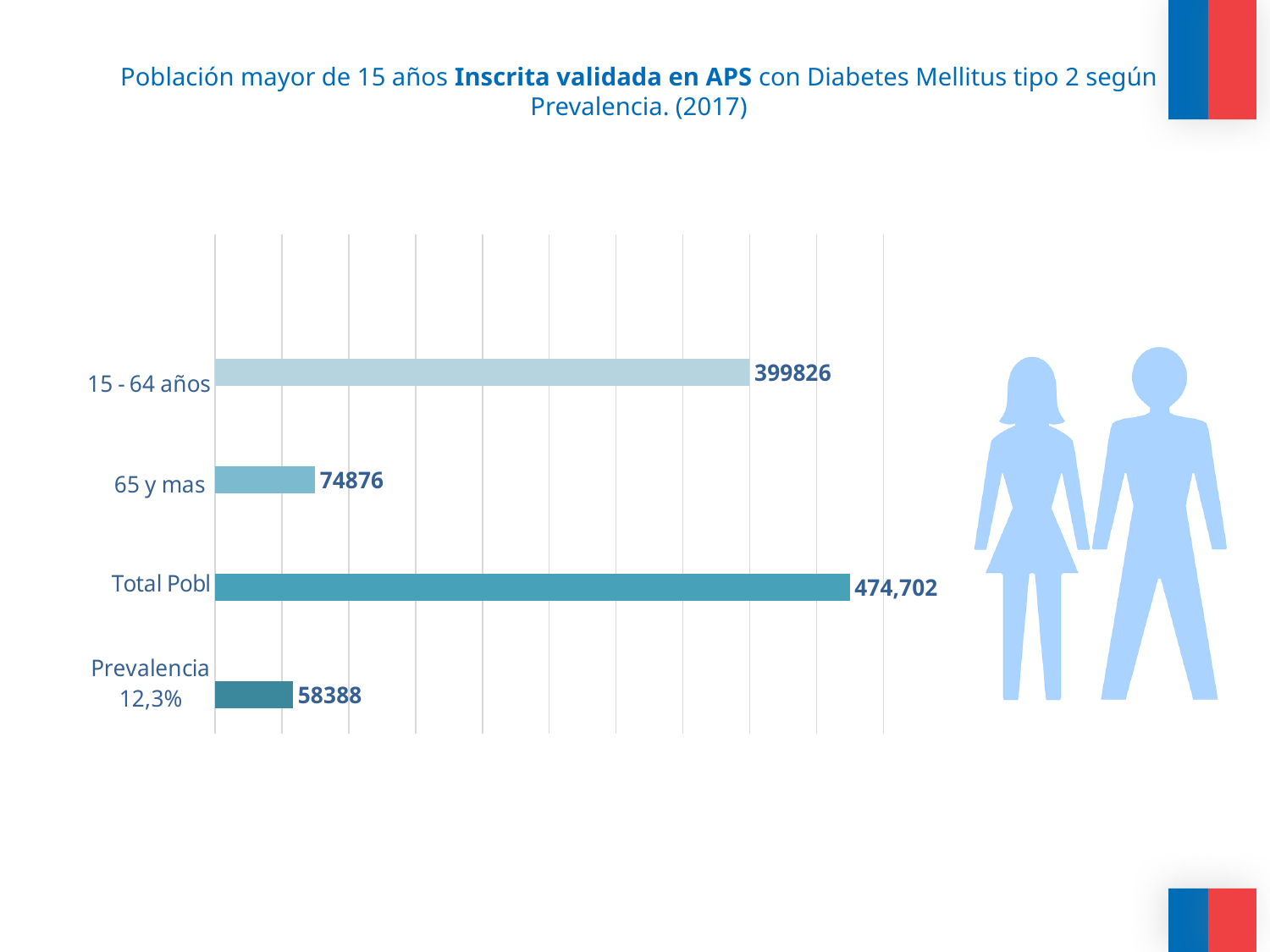
Which is larger, the value for "65 y mas" or the value for "Prevalencia 12,3%"? 65 y mas Which category has the lowest value? Prevalencia 12,3% How many categories are plotted in the chart? 4 What is the value for the "Total Pobl" category? 474,702 What is the difference between the values for "15 - 64 años" and "65 y mas"? 324950 What is the difference between the values for "65 y mas" and "Prevalencia 12,3%"? 16488 What year is given in the chart title? 2017 Which category has the highest value? Total Pobl What type of chart is shown on the slide? bar chart What is the value for the "15 - 64 años" category? 399826 What is the value for the "65 y mas" category? 74876 What is the value for the "Prevalencia 12,3%" category? 58388